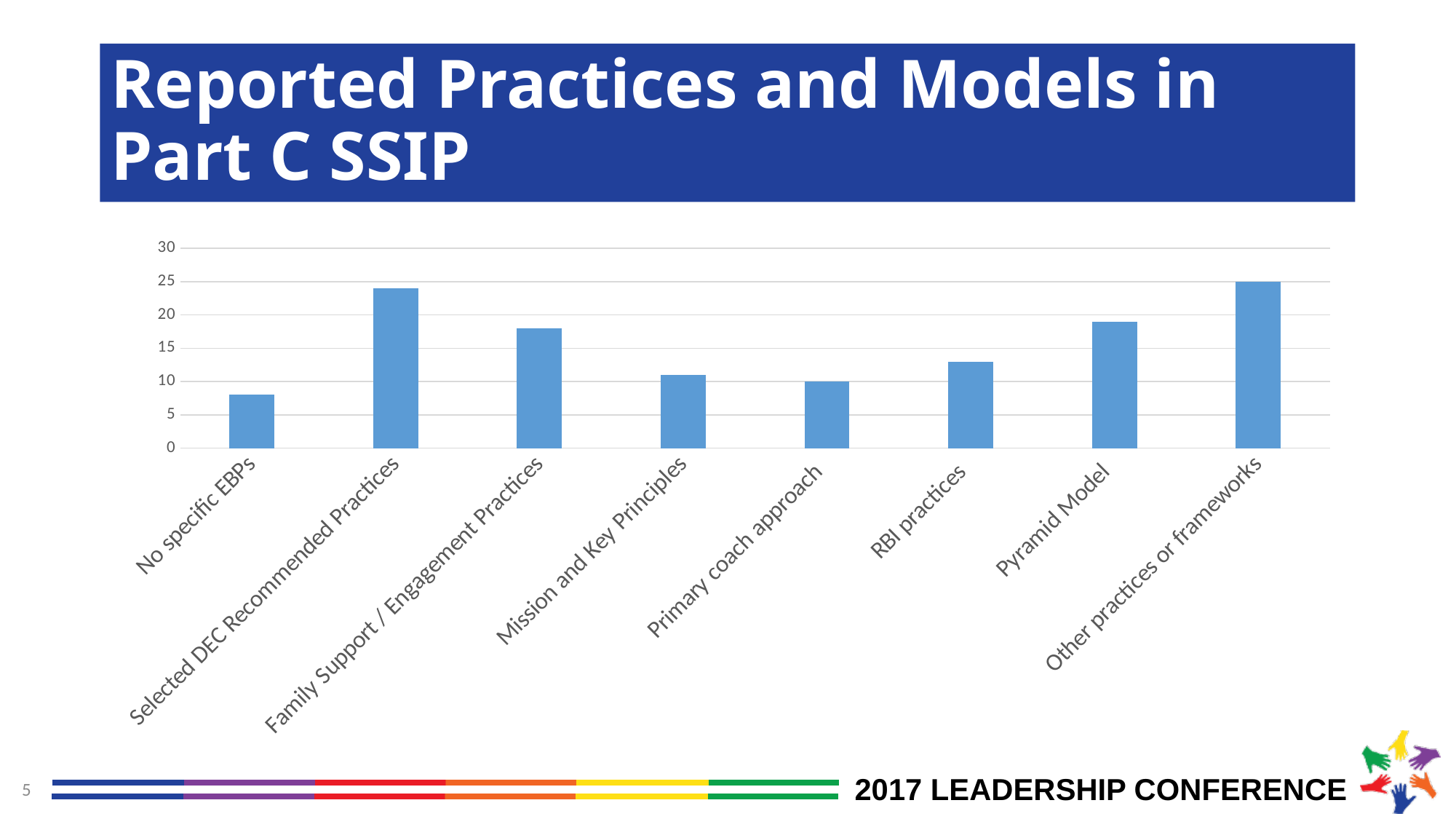
Which is larger, the value for Pyramid Model or the value for RBI practices? Pyramid Model How many categories are plotted on the chart? 8 Is the value for RBI practices greater or less than 15? less Is the value for Family Support / Engagement Practices greater or less than 15? greater Is the value for Pyramid Model greater or less than 20? less Which is larger, the value for Selected DEC Recommended Practices or the value for Family Support / Engagement Practices? Selected DEC Recommended Practices What is the title of the slide containing the chart? Reported Practices and Models in Part C SSIP What kind of chart is shown on the slide? bar chart Which category has the lowest value? No specific EBPs